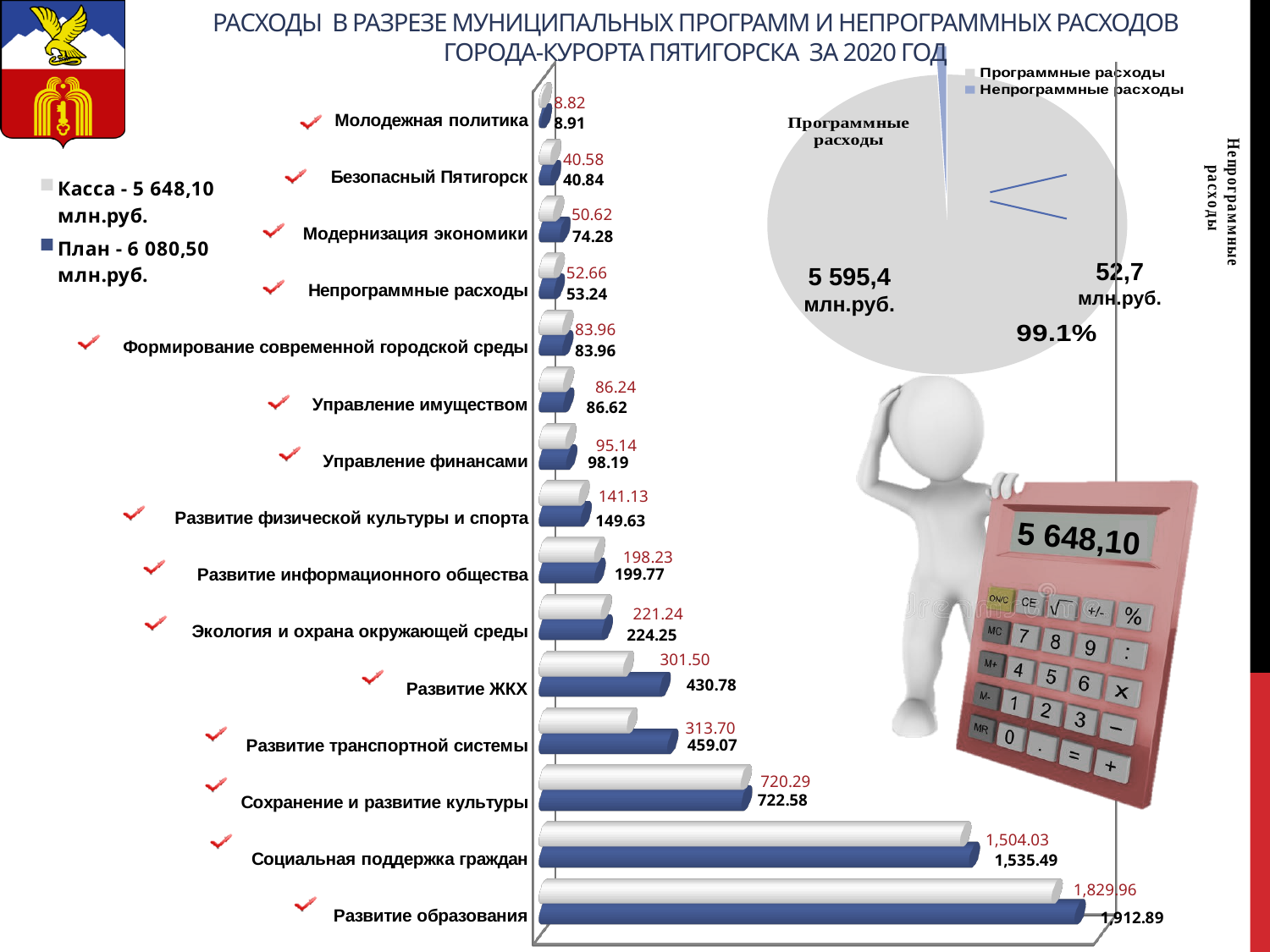
On the bar chart, what is the План value for Развитие транспортной системы? 459.07 How many categories are shown on the bar chart? 15 On the pie chart, what percentage share is shown for Программные расходы? 99.1% How many series does the bar chart's legend list? 2 What kind of chart is the chart on the left side of the slide? bar chart On the bar chart, which category has the highest План value? Развитие образования On the pie chart, what value is shown for Программные расходы? 5 595,4 млн.руб. On the bar chart, which is larger: the План value for Развитие ЖКХ or the План value for Развитие транспортной системы? Развитие транспортной системы On the bar chart, what is the План value for Социальная поддержка граждан? 1,535.49 On the bar chart, which category has the lowest Касса value? Молодежная политика On the bar chart, what is the difference between the План and Касса values for Модернизация экономики? 23.66 On the bar chart, what is the Касса value for Развитие ЖКХ? 301.50